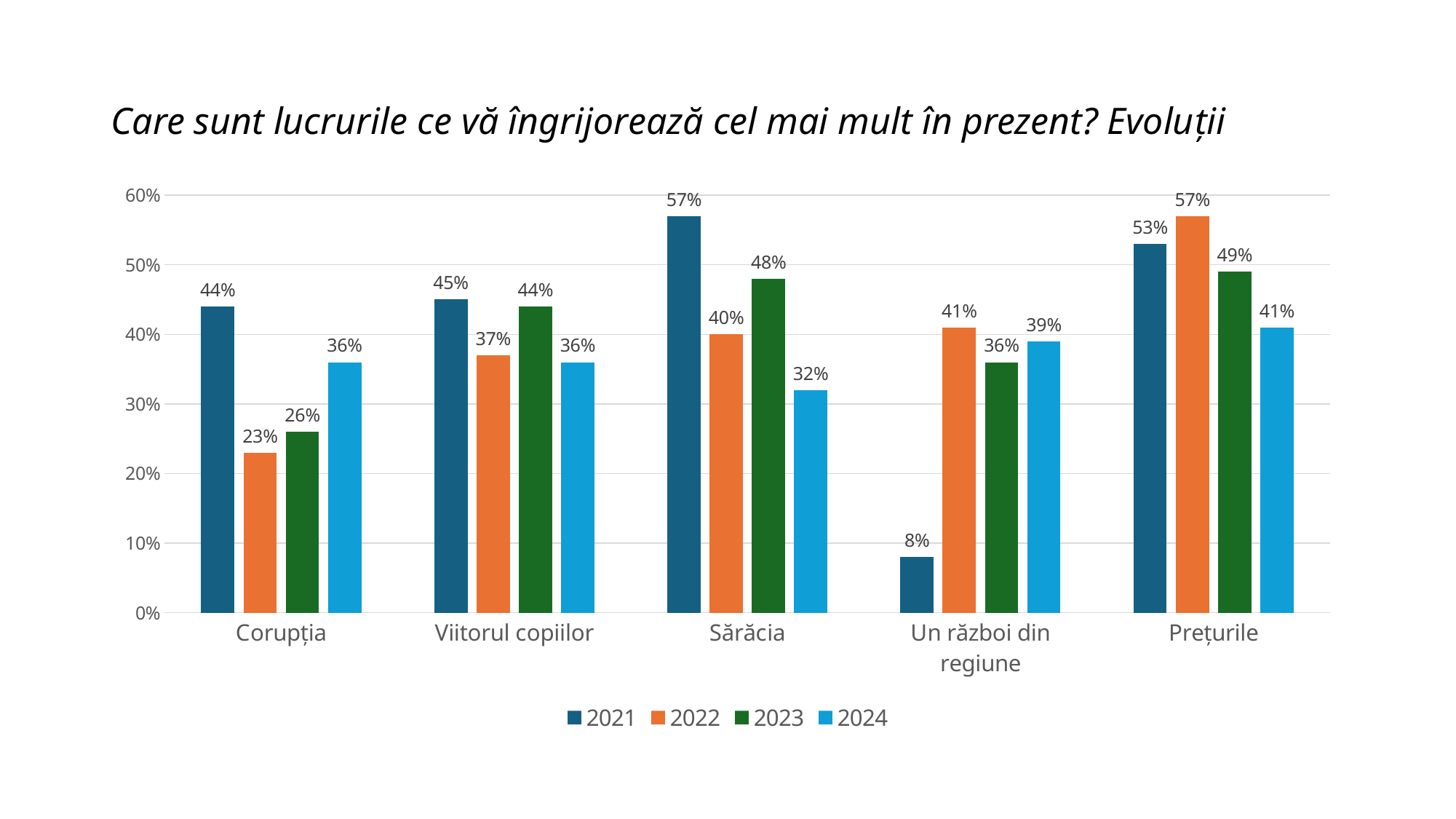
Which category has the lowest value in 2021? Un război din regiune What is the value for Corupția in 2023? 26% How many series does the legend list? 4 Which series is shown in orange in the legend? 2022 What kind of chart is shown on the slide? bar chart Which is larger for Viitorul copiilor: the 2022 value or the 2023 value? 2023 Which category has the highest value in 2022? Prețurile What is the difference between the 2021 and 2024 values for Sărăcia? 25% What is the value for Sărăcia in 2021? 57% Do the values for Prețurile rise or fall from 2022 to 2024? fall How many categories are shown on the x axis? 5 What is the value for Un război din regiune in 2022? 41%